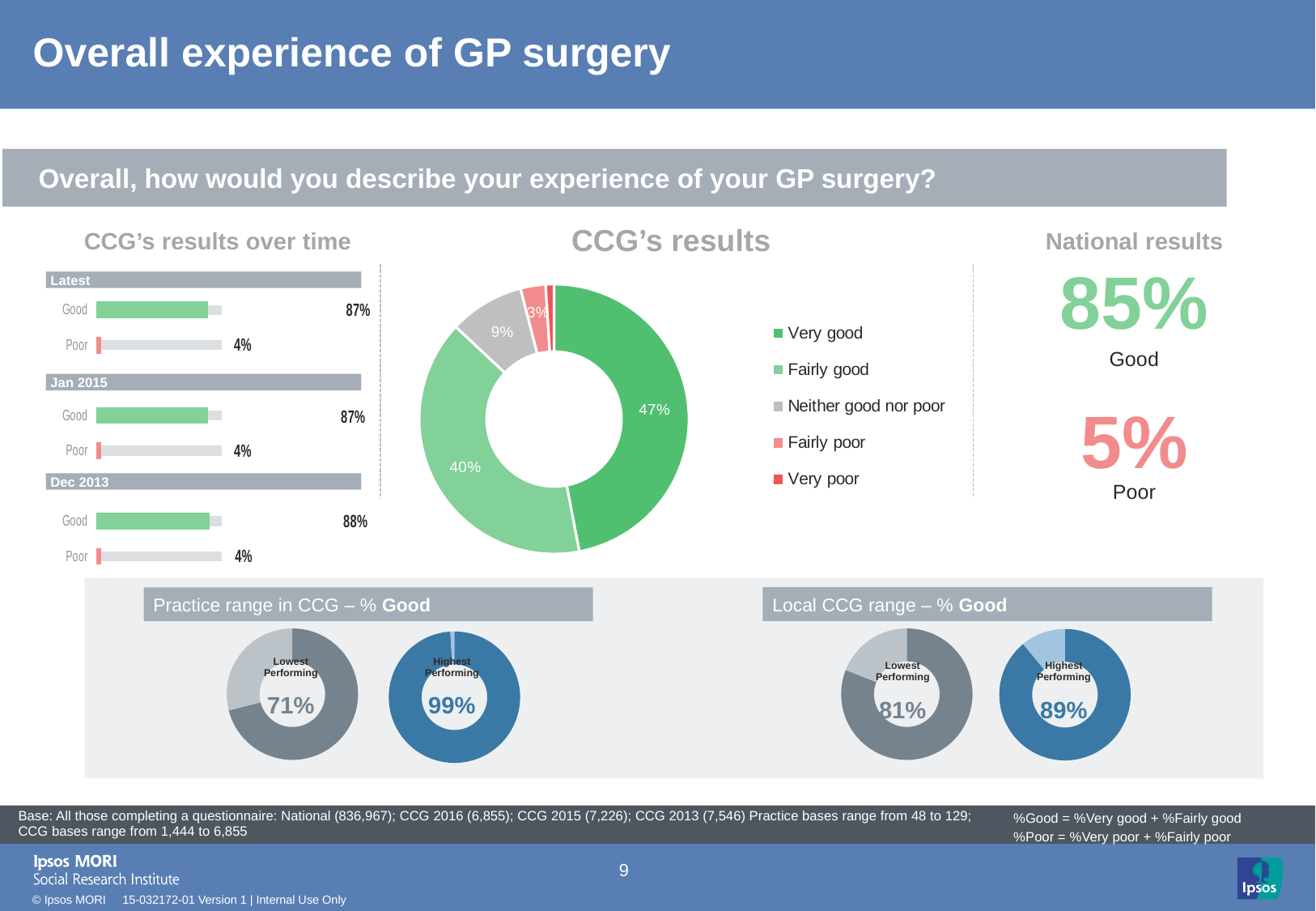
In the "CCG's results over time" chart, is the Good value for Latest larger or smaller than the Good value for Dec 2013? Smaller In the "CCG's results over time" chart, what is the Poor value for Latest? 4% In the "CCG's results over time" chart, what is the Good value for Dec 2013? 88% In the "CCG's results" donut chart, what percentage is shown for Neither good nor poor? 9% In the "CCG's results" donut chart, what percentage is shown for Fairly good? 40% In the "CCG's results" donut chart, what is the difference between the Very good and Fairly good percentages? 7% In the "CCG's results" donut chart, how many entries does the legend list? 5 In the "CCG's results over time" chart, what kind of chart is used? Bar chart In the "Local CCG range – % Good" section, what is the difference between the Highest Performing and Lowest Performing values? 8% In the "Practice range in CCG – % Good" section, what is the Highest Performing value? 99% In the "CCG's results" donut chart, which category has the largest share? Very good In the "CCG's results" donut chart, what percentage is shown for Very good? 47%